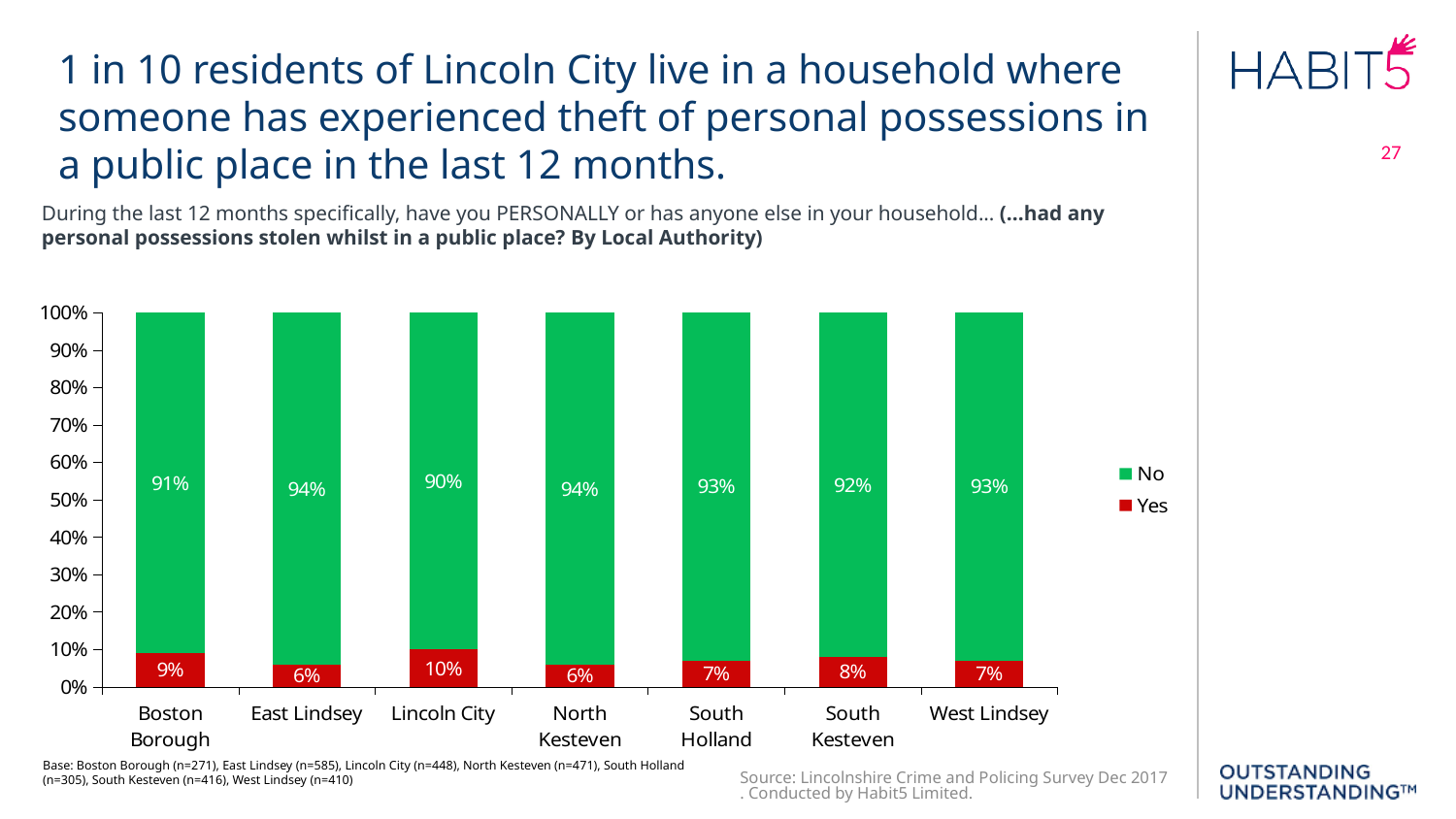
What is the 'Yes' value for Lincoln City? 10% How many local authorities are shown on the x axis? 7 What is the difference between the 'Yes' values for Lincoln City and East Lindsey? 4% Which local authority has the lowest 'No' value? Lincoln City How many series does the legend list? 2 Which local authority has the highest 'Yes' value? Lincoln City Which has a larger 'Yes' value, Boston Borough or South Holland? Boston Borough What is the 'No' value for East Lindsey? 94% What is the 'Yes' value for South Kesteven? 8% What is the total of the stacked bar for Boston Borough? 100% What kind of chart is shown on the slide? Stacked bar chart Which colour represents the 'Yes' series in the legend? Red